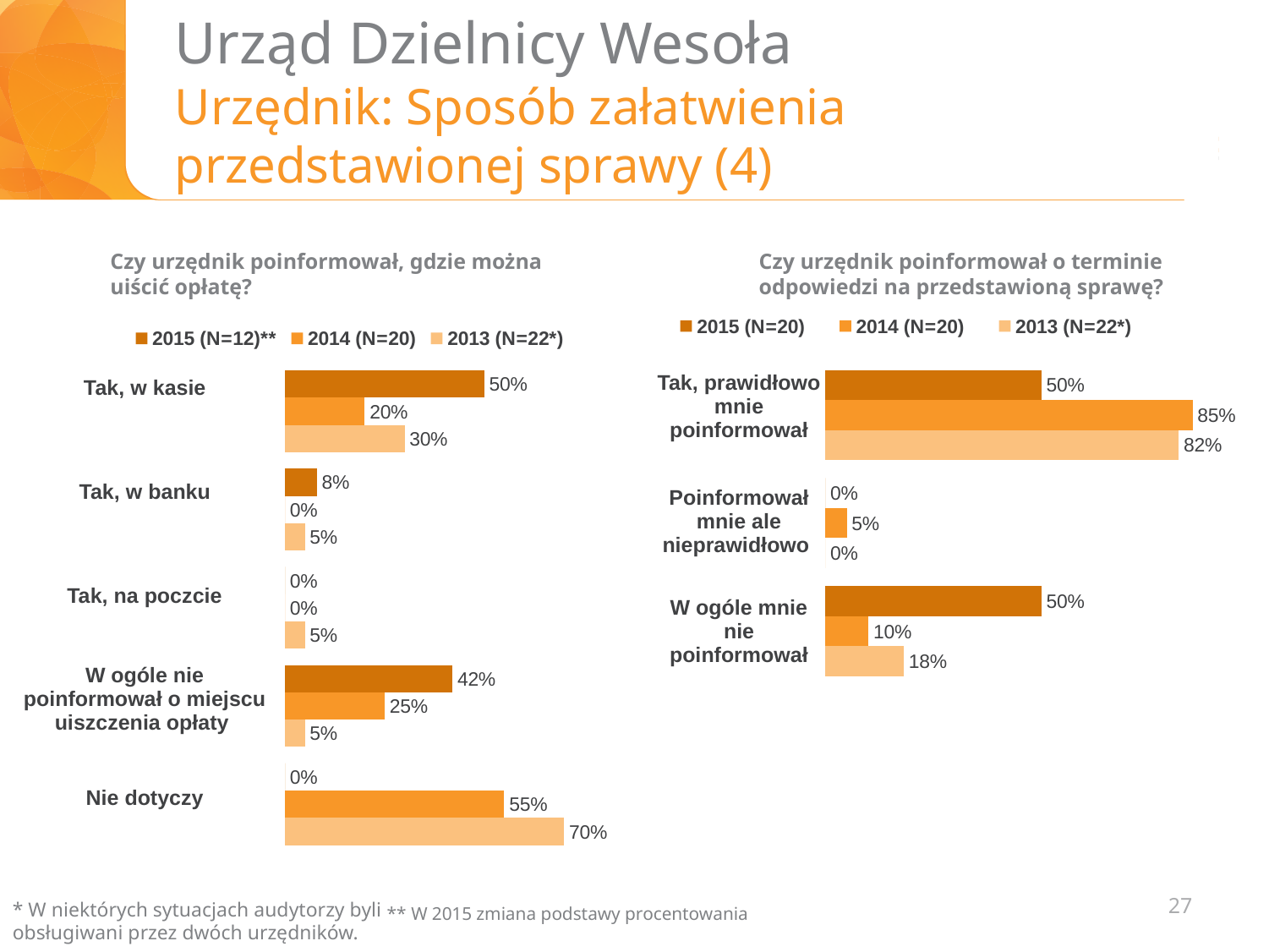
In the right chart ("Czy urzędnik poinformował o terminie odpowiedzi na przedstawioną sprawę?"), what is the value for "W ogóle mnie nie poinformował" in the 2013 (N=22*) series? 18% In the right chart ("Czy urzędnik poinformował o terminie odpowiedzi na przedstawioną sprawę?"), which is larger for "Tak, prawidłowo mnie poinformował": the 2014 value or the 2013 value? 2014 What type of chart is used on the right side of the slide? Bar chart In the left chart ("Czy urzędnik poinformował, gdzie można uiścić opłatę?"), what is the difference between the 2015 and 2014 values for "W ogóle nie poinformował o miejscu uiszczenia opłaty"? 17 percentage points In the left chart ("Czy urzędnik poinformował, gdzie można uiścić opłatę?"), which category has the highest value in the 2014 (N=20) series? Nie dotyczy In the right chart ("Czy urzędnik poinformował o terminie odpowiedzi na przedstawioną sprawę?"), what is the difference between the 2015 and 2014 values for "W ogóle mnie nie poinformował"? 40 percentage points In the left chart ("Czy urzędnik poinformował, gdzie można uiścić opłatę?"), what is the value for "Tak, w kasie" in the 2015 (N=12)** series? 50% In the left chart ("Czy urzędnik poinformował, gdzie można uiścić opłatę?"), how many categories are shown? 5 In the right chart ("Czy urzędnik poinformował o terminie odpowiedzi na przedstawioną sprawę?"), what is the value for "Tak, prawidłowo mnie poinformował" in the 2014 (N=20) series? 85% In the left chart ("Czy urzędnik poinformował, gdzie można uiścić opłatę?"), what is the value for "Nie dotyczy" in the 2013 (N=22*) series? 70% In the left chart ("Czy urzędnik poinformował, gdzie można uiścić opłatę?"), how many series does the legend list? 3 In the right chart ("Czy urzędnik poinformował o terminie odpowiedzi na przedstawioną sprawę?"), what is the sample size shown in the legend for 2015? N=20